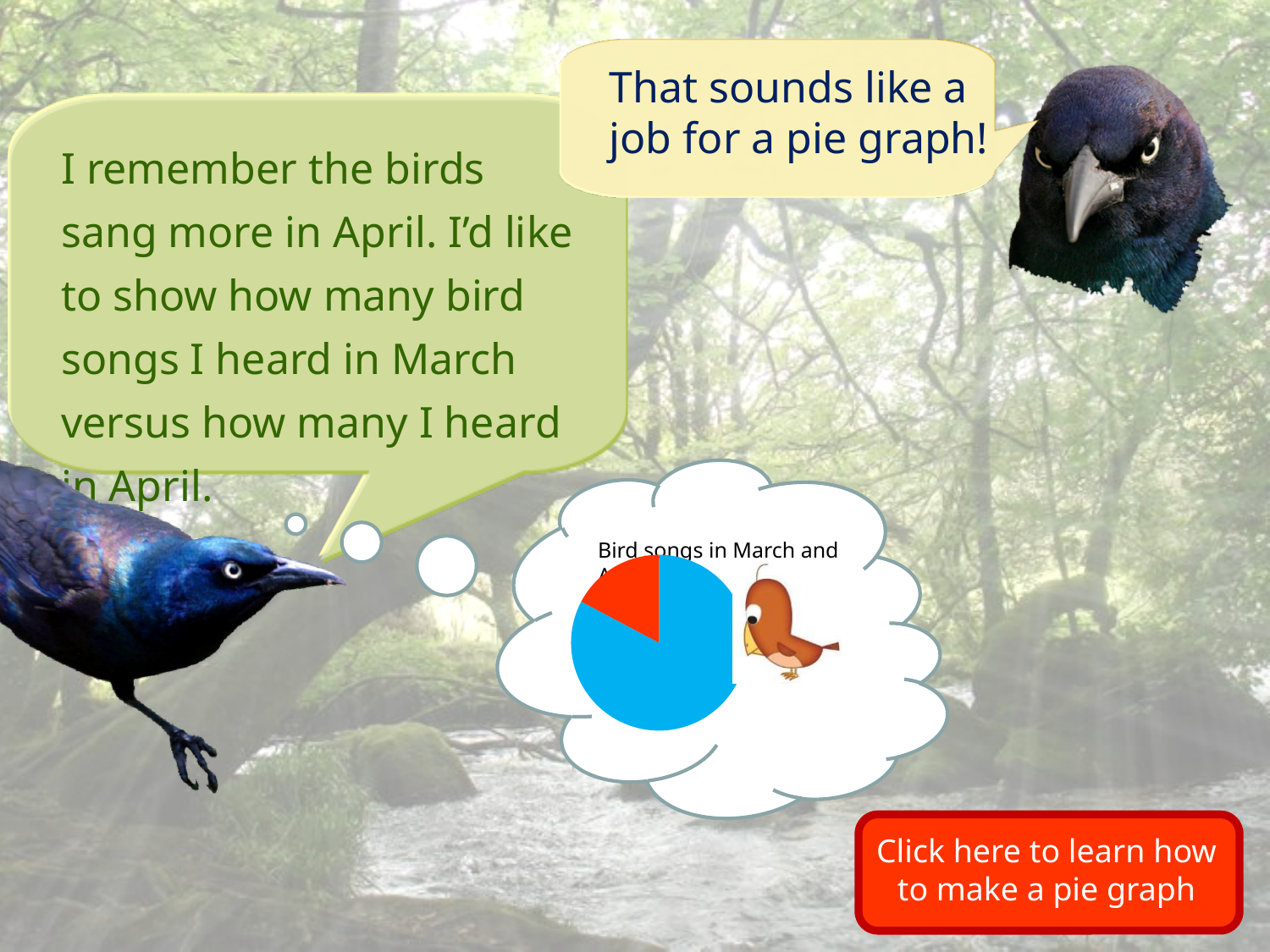
Which colour slice of the pie chart is the smallest? orange Does the blue slice take up more or less than half of the pie chart? more Which slice of the pie chart is larger, the blue one or the orange one? blue What colours are the two slices of the pie chart? blue and orange How many slices does the pie chart have? 2 Which two months does the pie chart's title refer to? March and April What kind of chart is shown inside the thought cloud? pie chart